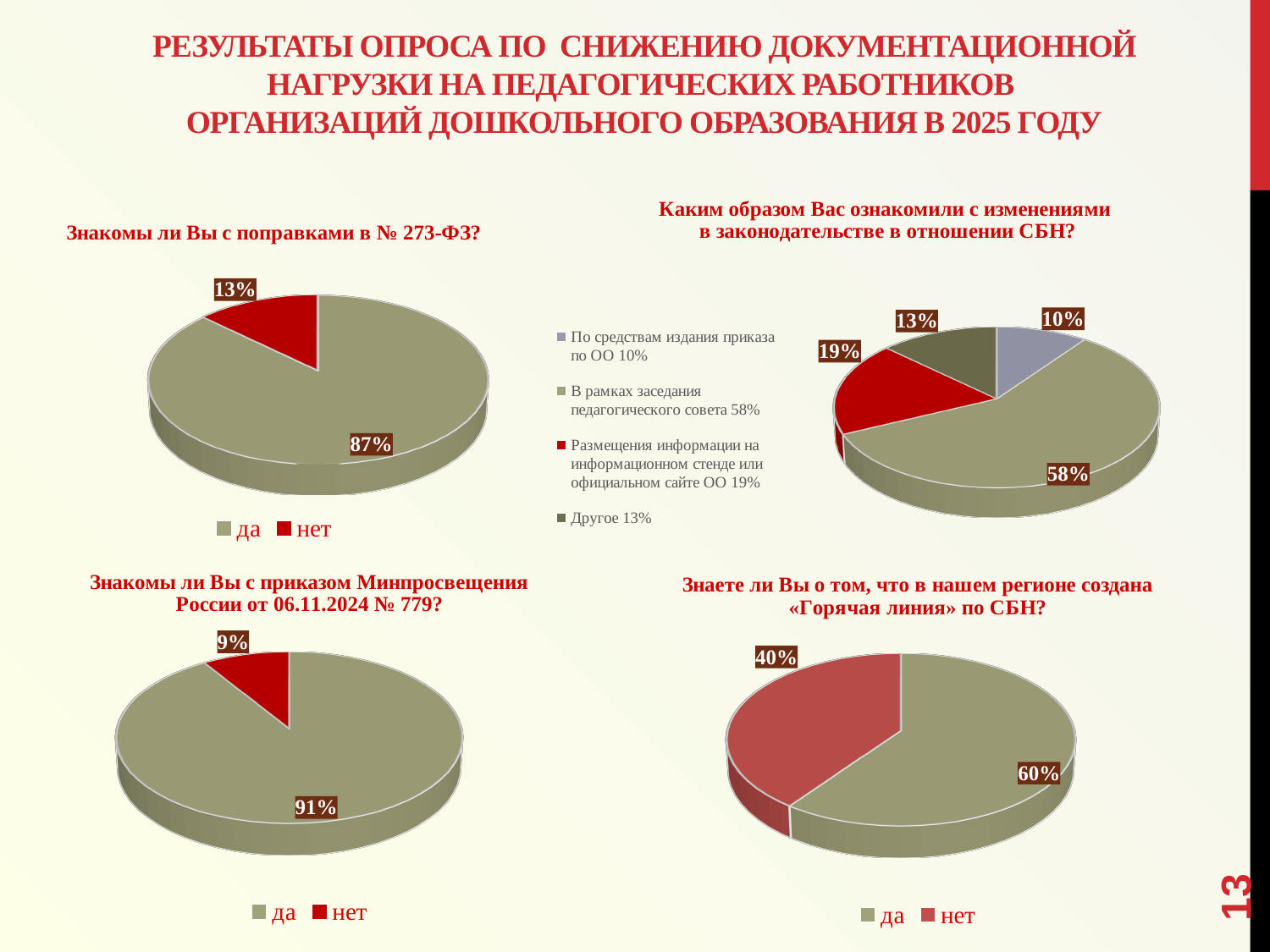
In the chart titled «Знакомы ли Вы с приказом Минпросвещения России от 06.11.2024 № 779?», what is the difference between the «да» and «нет» shares? 82% In the chart titled «Каким образом Вас ознакомили с изменениями в законодательстве в отношении СБН?», how many categories does the legend list? 4 In the chart titled «Каким образом Вас ознакомили с изменениями в законодательстве в отношении СБН?», what is the share for «Размещения информации на информационном стенде или официальном сайте ОО»? 19% In the chart titled «Знакомы ли Вы с приказом Минпросвещения России от 06.11.2024 № 779?», what share of respondents answered «нет»? 9% In the chart titled «Каким образом Вас ознакомили с изменениями в законодательстве в отношении СБН?», which option has the smallest share? По средствам издания приказа по ОО In the chart titled «Знаете ли Вы о том, что в нашем регионе создана «Горячая линия» по СБН?», what share of respondents answered «нет»? 40% In the chart titled «Знакомы ли Вы с поправками в № 273-ФЗ?», what share of respondents answered «нет»? 13% In the chart titled «Знакомы ли Вы с поправками в № 273-ФЗ?», what share of respondents answered «да»? 87% What type of chart is used for the bottom-right chart on the slide? Pie chart In the chart titled «Каким образом Вас ознакомили с изменениями в законодательстве в отношении СБН?», what is the difference between the shares for «В рамках заседания педагогического совета» and «Другое»? 45% In the chart titled «Знаете ли Вы о том, что в нашем регионе создана «Горячая линия» по СБН?», which answer has the larger share, «да» or «нет»? да In the chart titled «Каким образом Вас ознакомили с изменениями в законодательстве в отношении СБН?», which option has the largest share? В рамках заседания педагогического совета